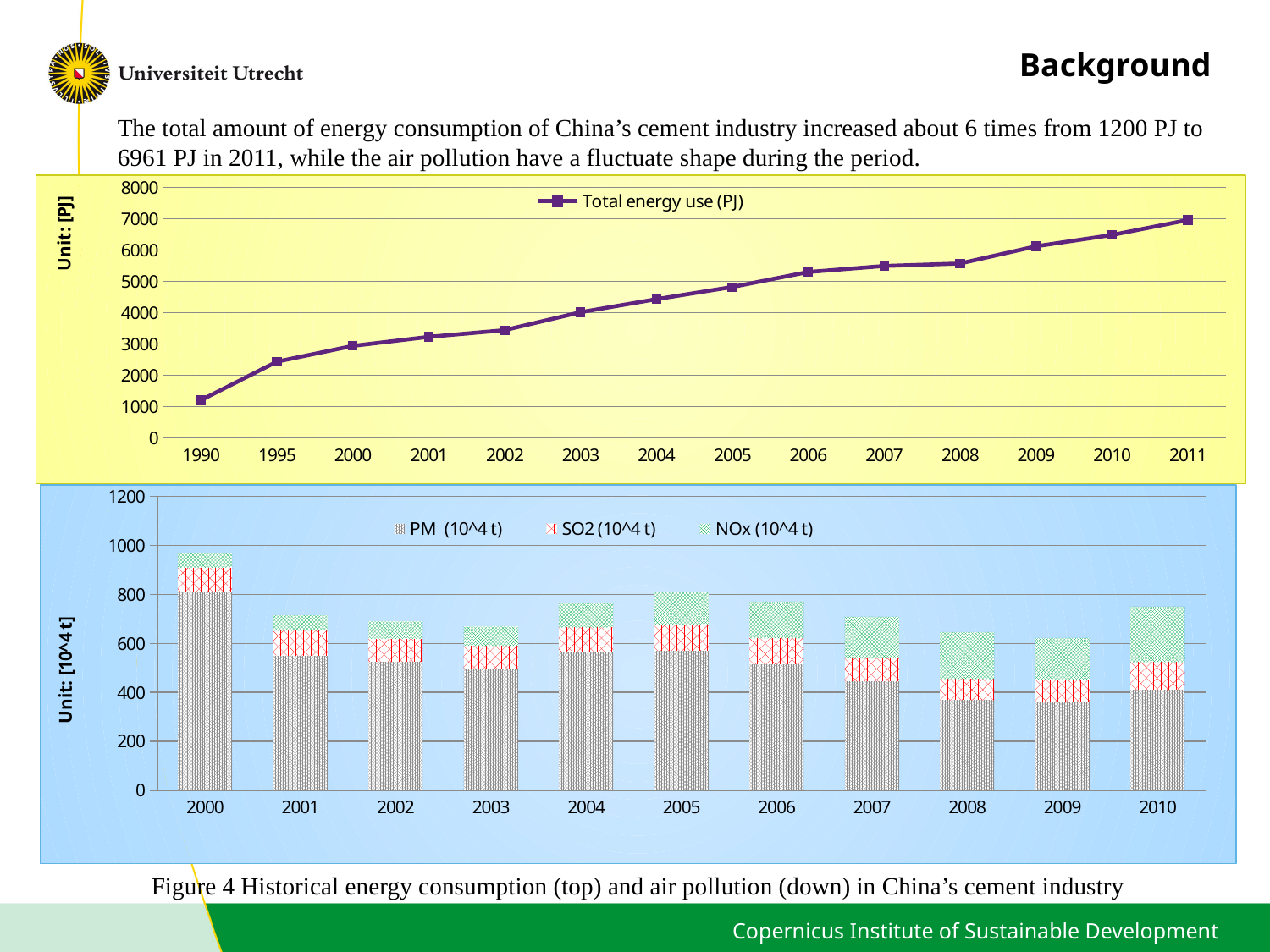
What kind of chart is the bottom chart (air pollution)? bar chart In the top chart, is the total energy use for 2006 greater or less than 5000? greater What kind of chart is the top chart (Total energy use)? line chart In the bottom chart, is the total stacked value for 2007 greater or less than 800? less In the top chart, which year has the lowest total energy use? 1990 In the bottom chart, which series is shown at the bottom of each stacked bar? PM (10^4 t) In the top chart, is the total energy use for 1995 greater or less than 2000? greater In the bottom chart, which year has the tallest stacked bar? 2000 In the top chart, does total energy use rise or fall from 1990 to 2011? rise In the top chart, which year has the highest total energy use? 2011 In the top chart, how many years are plotted on the x axis? 14 In the bottom chart, how many series does the legend list? 3